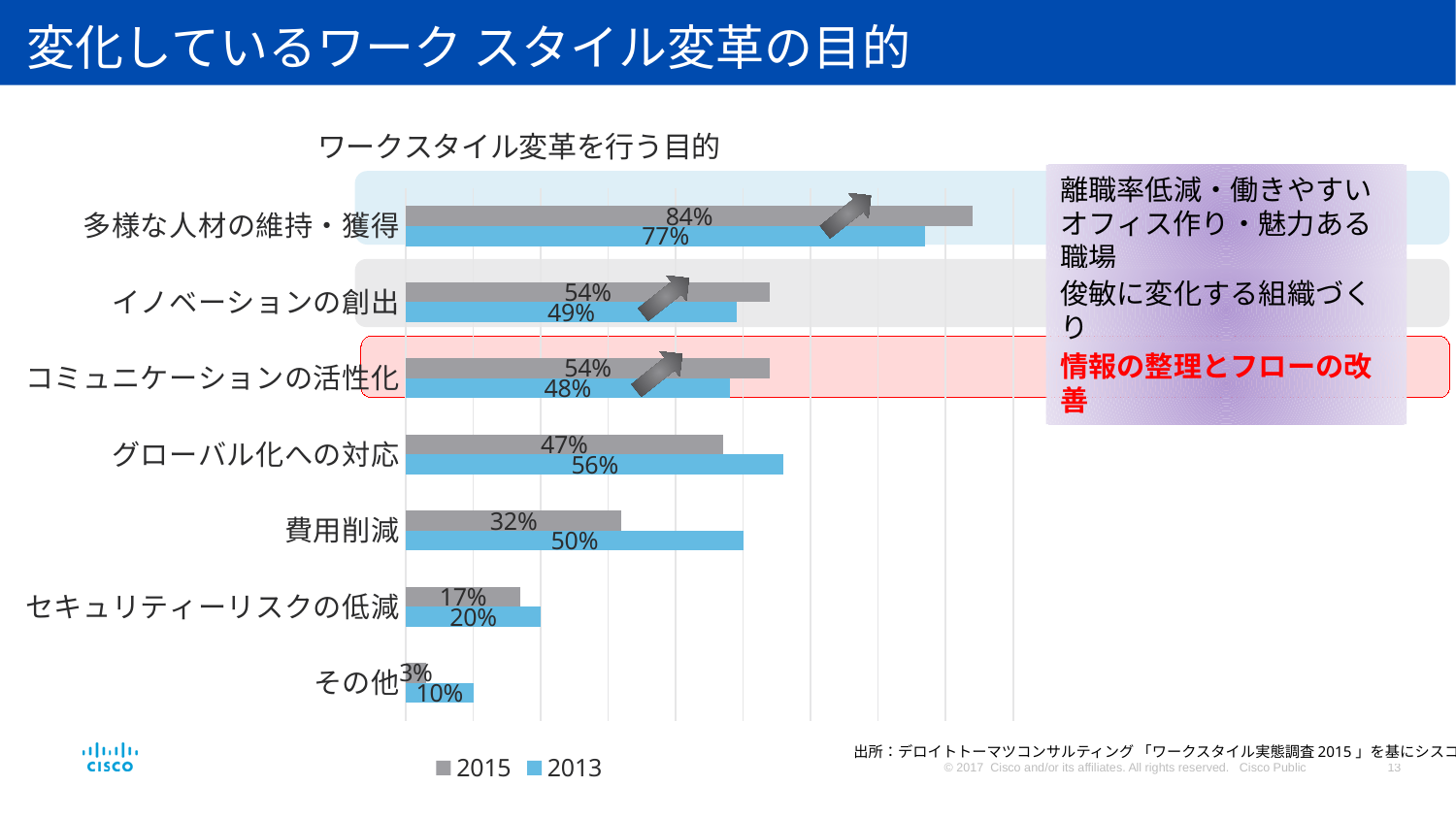
What kind of chart is shown on the slide? Bar chart How many categories are shown in the chart? 7 What is the difference between the 2015 and 2013 values for 多様な人材の維持・獲得? 7% What is the 2015 value for 多様な人材の維持・獲得? 84% What is the difference between the 2015 and 2013 values for 費用削減? 18% How many series does the legend list? 2 For グローバル化への対応, which is larger: the 2015 value or the 2013 value? 2013 Which category has the highest 2015 value? 多様な人材の維持・獲得 What is the 2013 value for 費用削減? 50% Which category has the lowest 2013 value? その他 What is the title of the chart? ワークスタイル変革を行う目的 What is the 2013 value for グローバル化への対応? 56%